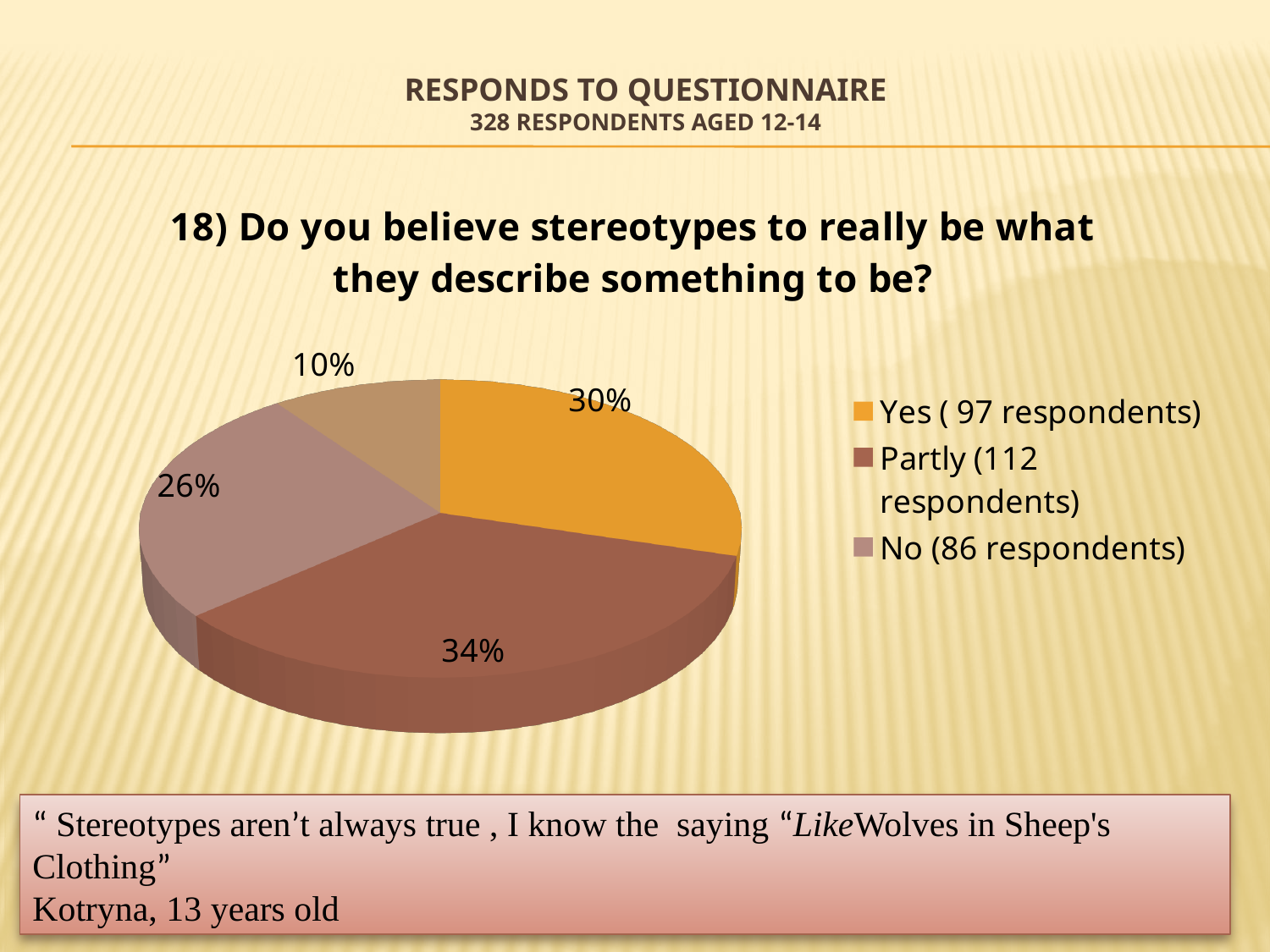
Which slice is larger, "Yes" or "No"? Yes How many respondents answered "Partly" according to the legend? 112 respondents What type of chart is shown on the slide? Pie chart How many entries does the legend list? 3 What is the smallest percentage shown on the pie chart? 10% What percentage of respondents answered "No"? 26% What percentage of respondents answered "Yes"? 30% What colour is the "Yes" slice of the pie chart? Orange How many percentage points larger is the "Partly" slice than the "Yes" slice? 4 percentage points What percentage of respondents answered "Partly"? 34% Which answer has the largest share of the pie? Partly How many slices does the pie chart have? 4